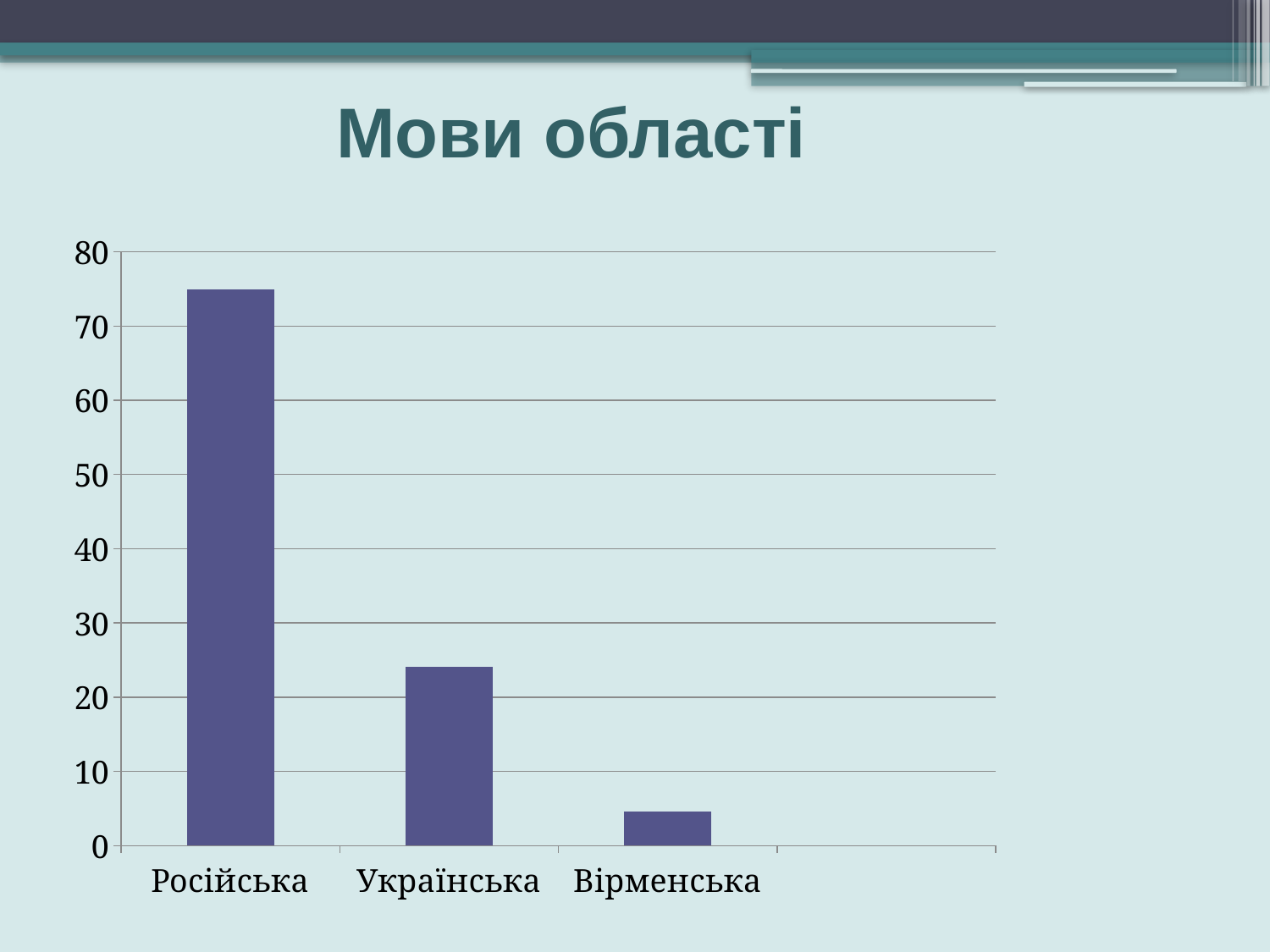
Which category has the lowest bar? Вірменська Is the value for Вірменська greater or less than 10? less What is the title of the chart? Мови області What kind of chart is shown on the slide? bar chart Is the value for Українська greater or less than 30? less Is the value for Російська greater or less than 80? less Do the bar values rise or fall from left to right along the x axis? fall Which category has the highest bar? Російська Which is larger, the value for Українська or the value for Вірменська? Українська Which is larger, the value for Російська or the value for Українська? Російська How many categories are shown on the x axis of the chart? 3